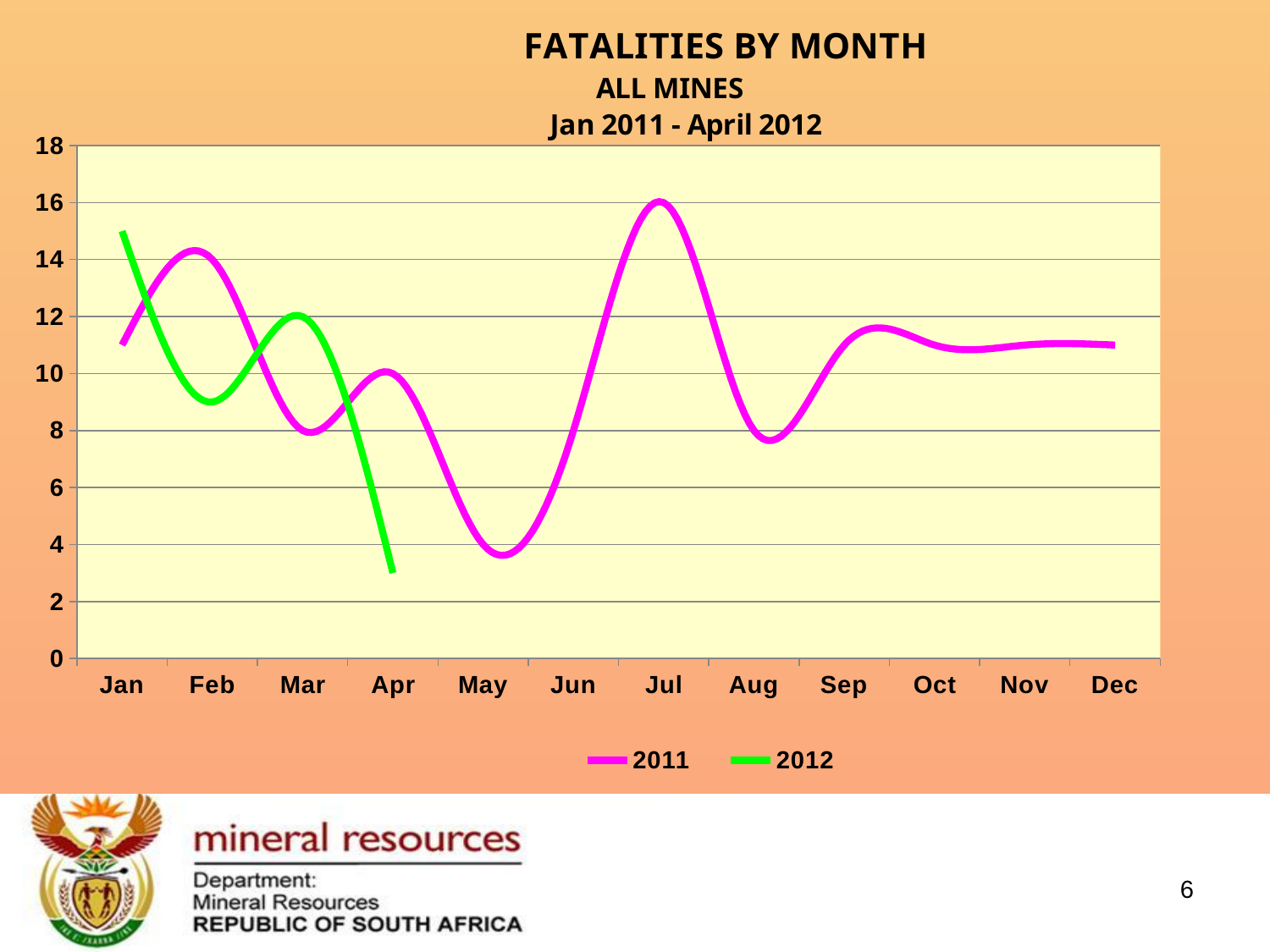
Is the value for Jul 2011 greater or less than 14? greater In which month did the 2011 series reach its lowest value? May Is the value for Apr 2012 greater or less than 4? less In which month did the 2012 series reach its highest value? Jan How many series does the legend list? 2 Which series has the higher value in Feb, 2011 or 2012? 2011 How many months are shown on the x axis? 12 Which series has the higher value in Jan, 2011 or 2012? 2012 Which colour is used for the 2012 series? green In which month did the 2011 series reach its highest value? Jul What kind of chart is shown on the slide? line chart In which month did the 2012 series reach its lowest value? Apr